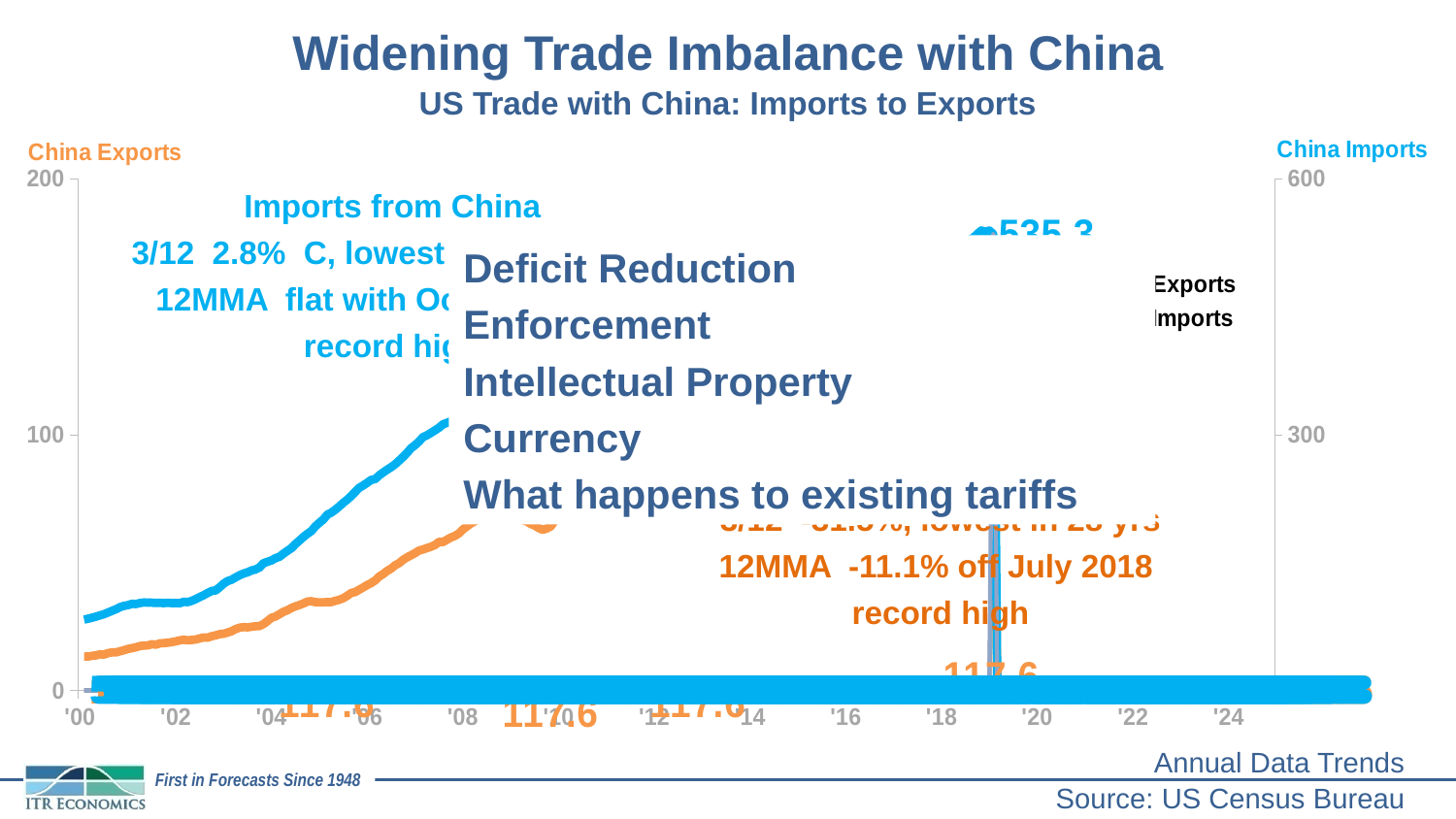
Does the Imports line rise or fall between '00 and '08? rise What are the two series named in the chart's legend? Exports, Imports Does the Exports line rise or fall between '00 and '08? rise What is the subtitle of the chart on the slide? US Trade with China: Imports to Exports What kind of chart is shown on the slide? line chart